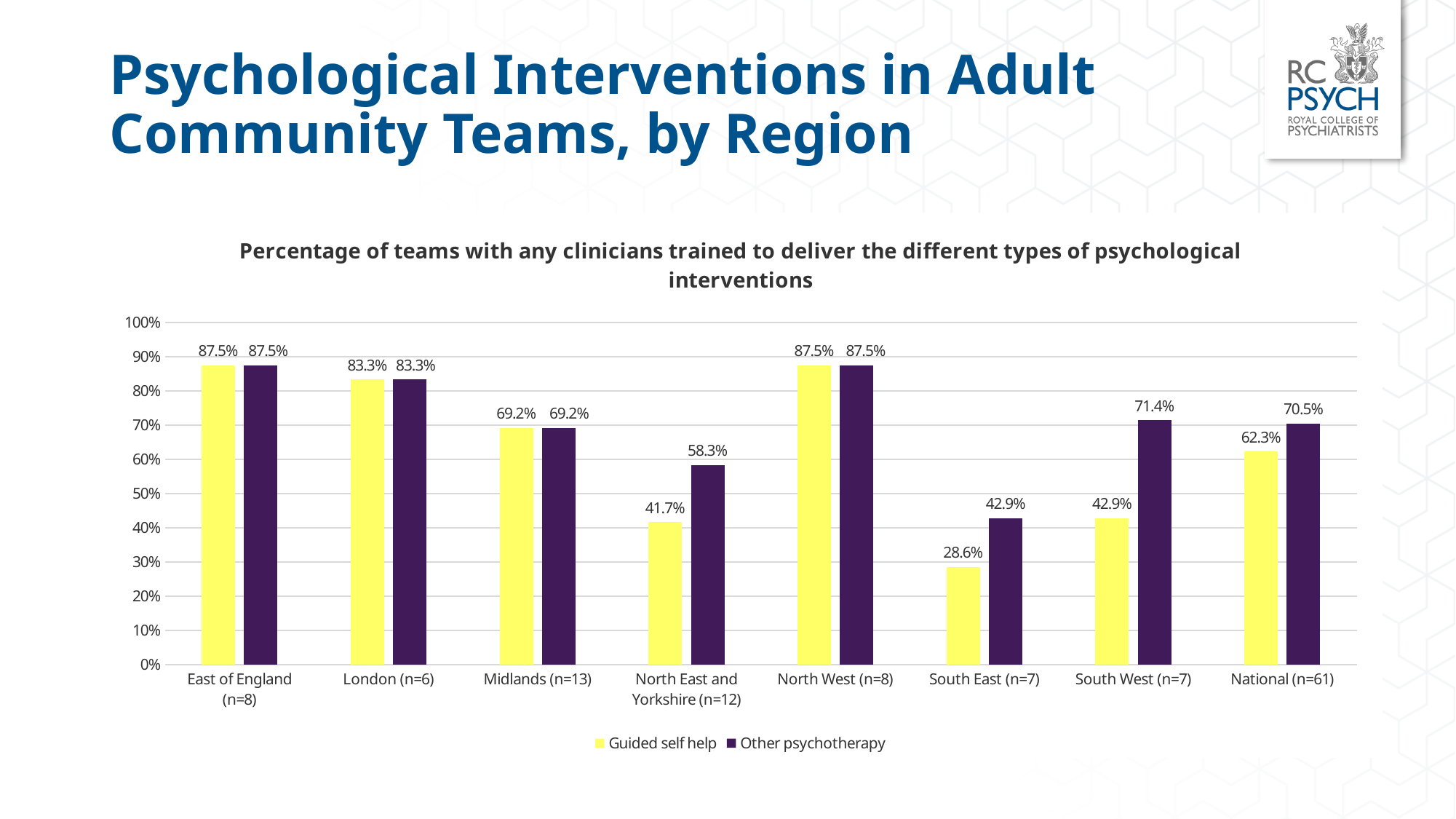
What is the difference between the Other psychotherapy and Guided self help values for South West (n=7)? 28.5% What is the Other psychotherapy value for National (n=61)? 70.5% Which region has the lowest Guided self help value? South East (n=7) What is the Other psychotherapy value for North East and Yorkshire (n=12)? 58.3% How many series does the legend list? 2 How many region categories are shown on the x axis? 8 Which is larger for National (n=61): Guided self help or Other psychotherapy? Other psychotherapy Which colour represents Guided self help in the chart? Yellow What is the difference between the Other psychotherapy and Guided self help values for North East and Yorkshire (n=12)? 16.6% What is the Guided self help value for South East (n=7)? 28.6% Which region has the lowest Other psychotherapy value? South East (n=7) What kind of chart is shown on the slide? Bar chart